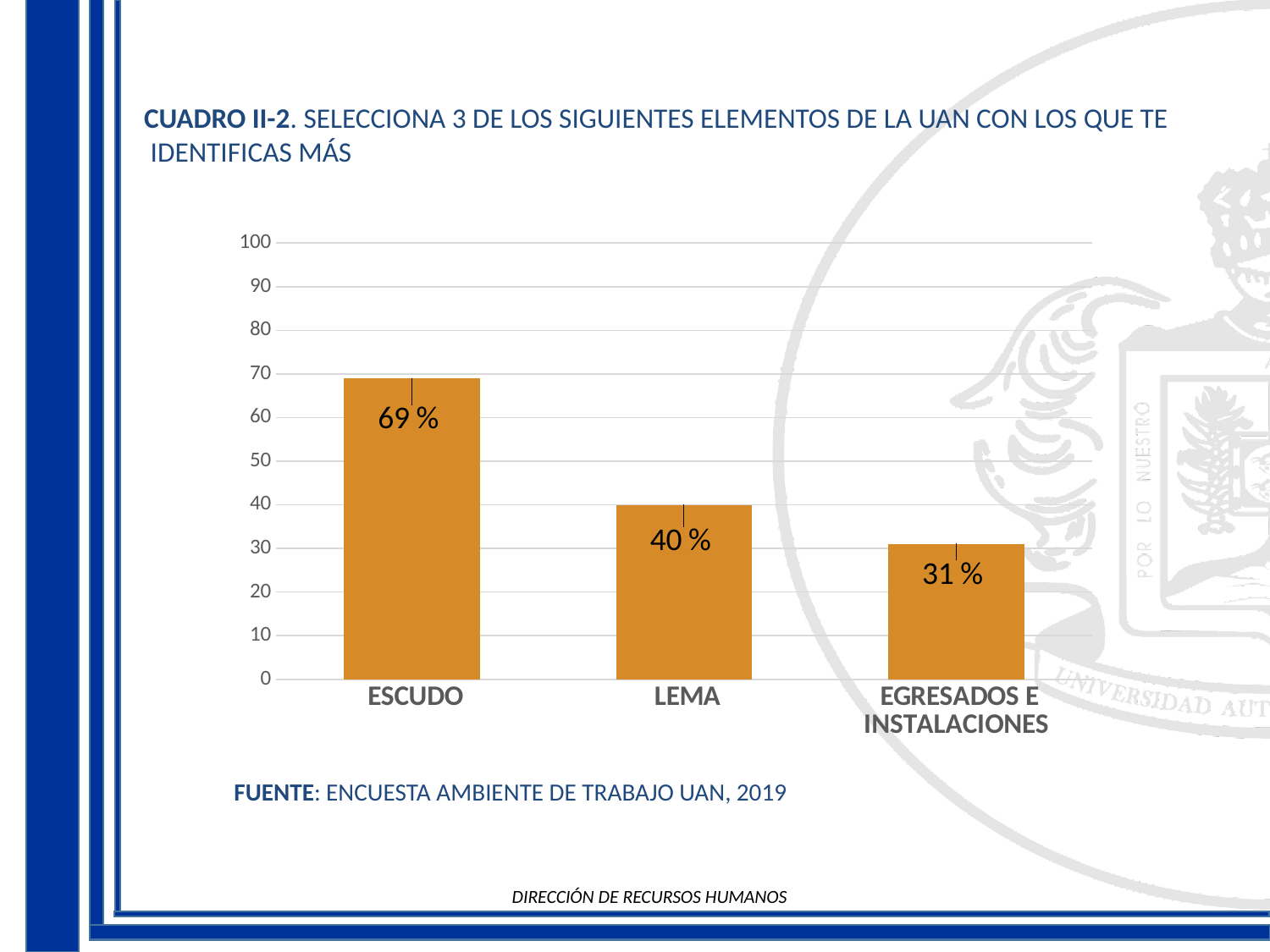
What is the value for LEMA? 40 % Which is larger, the value for LEMA or the value for EGRESADOS E INSTALACIONES? LEMA Do the values rise or fall from left to right along the x axis? fall What kind of chart is shown on the slide? bar chart Is the value for ESCUDO greater or less than 50? greater What is the difference between the values for ESCUDO and LEMA? 29 % Which category has the lowest value? EGRESADOS E INSTALACIONES What is the value for ESCUDO? 69 % What is the value for EGRESADOS E INSTALACIONES? 31 % What is the difference between the values for LEMA and EGRESADOS E INSTALACIONES? 9 % Which category has the highest value? ESCUDO How many categories are shown on the x axis? 3